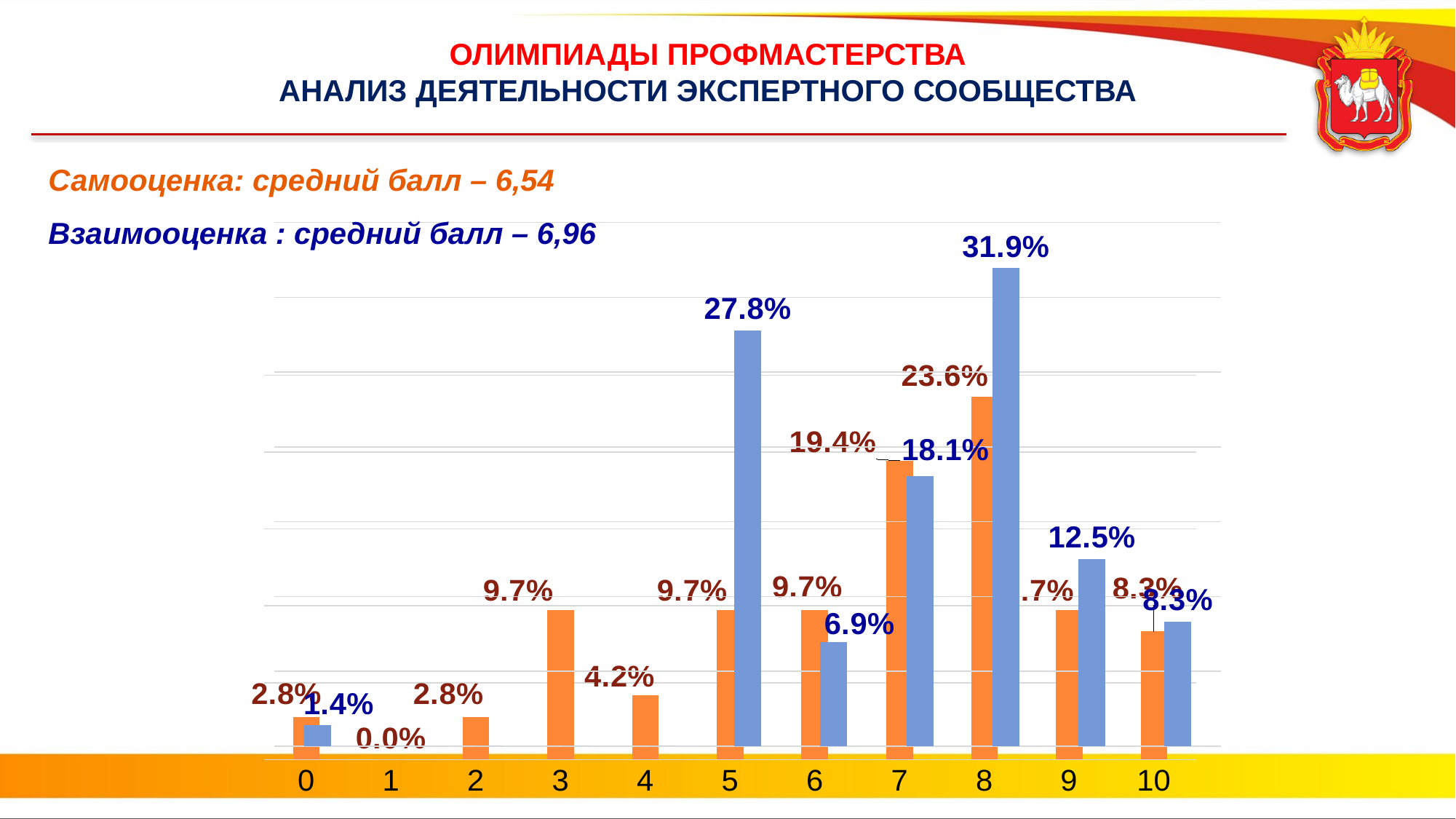
What is the value of the orange bar for category 8? 23.6% What is the value of the blue bar for category 5? 27.8% Which category has the highest orange bar? 8 What is the value of the blue bar for category 8? 31.9% What is the value of the orange bar for category 1? 0.0% What kind of chart is shown on the slide? bar chart Which category has the highest blue bar? 8 How many categories are shown on the x axis? 11 What is the value of the orange bar for category 4? 4.2% For category 8, how much larger is the blue bar than the orange bar? 8.3 percentage points For category 5, what is the difference between the blue bar (27.8%) and the orange bar (9.7%)? 18.1 percentage points For category 7, which bar is larger, the orange or the blue? orange